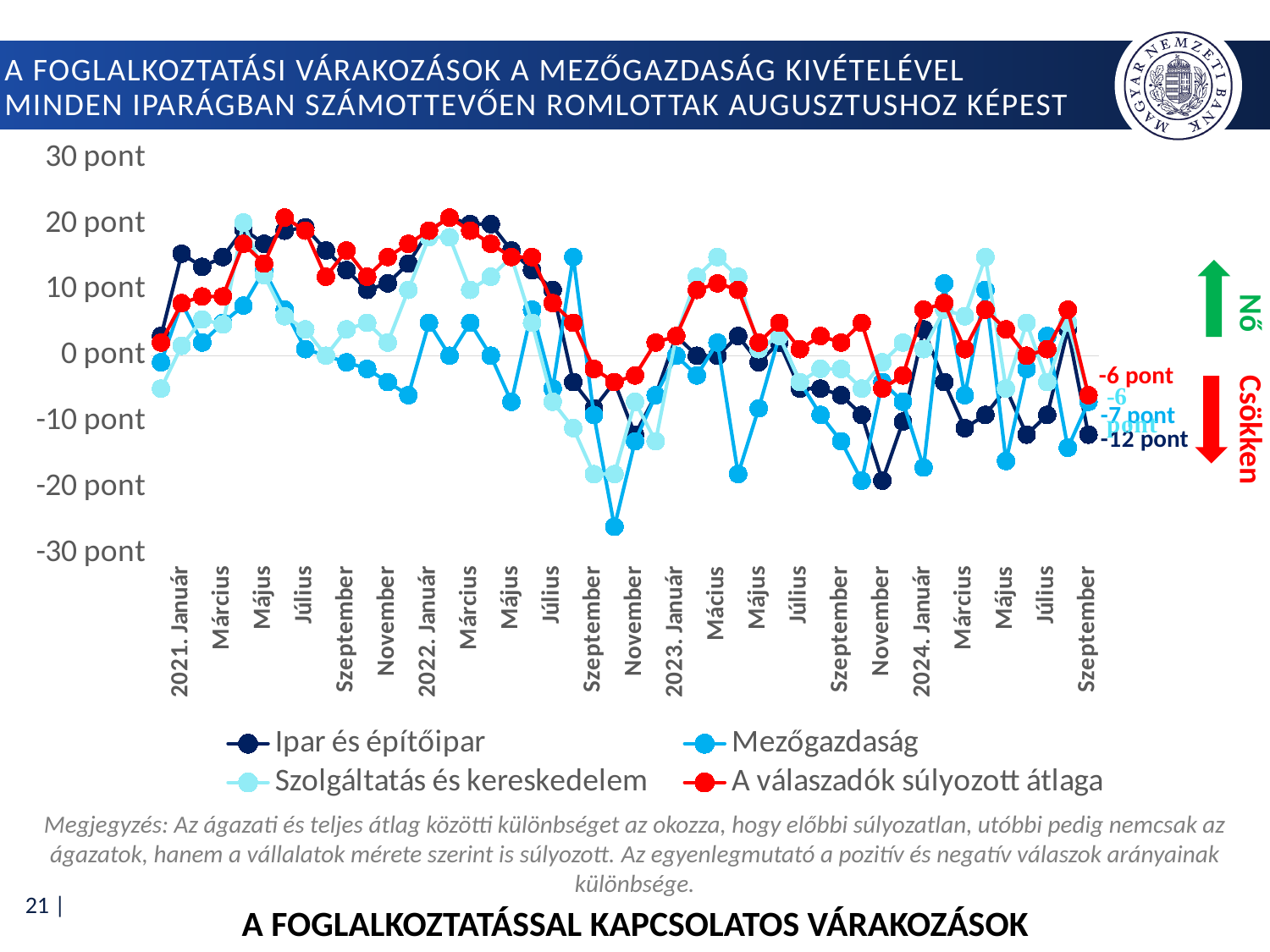
What is the value of Ipar és építőipar at the last point (2024 Szeptember), as labelled on the chart? -12 pont Which series has the lowest value at the last point (2024 Szeptember)? Ipar és építőipar What is the value of Szolgáltatás és kereskedelem at the last point (2024 Szeptember), as labelled on the chart? -6 pont At the last point (2024 Szeptember), which is larger: the value for A válaszadók súlyozott átlaga or the value for Ipar és építőipar? A válaszadók súlyozott átlaga How many series does the legend list? 4 What kind of chart is shown on the slide? line chart Which series is shown in red in the legend? A válaszadók súlyozott átlaga Is the value for Mezőgazdaság at 2022 November greater or less than -20 pont? greater What is the highest value shown on the vertical axis? 30 pont What is the value of A válaszadók súlyozott átlaga at the last point (2024 Szeptember), as labelled on the chart? -6 pont What is the difference between the labelled values of A válaszadók súlyozott átlaga (-6 pont) and Ipar és építőipar (-12 pont) at 2024 Szeptember? 6 pont Is the value for A válaszadók súlyozott átlaga at 2022 Március greater or less than 10 pont? greater